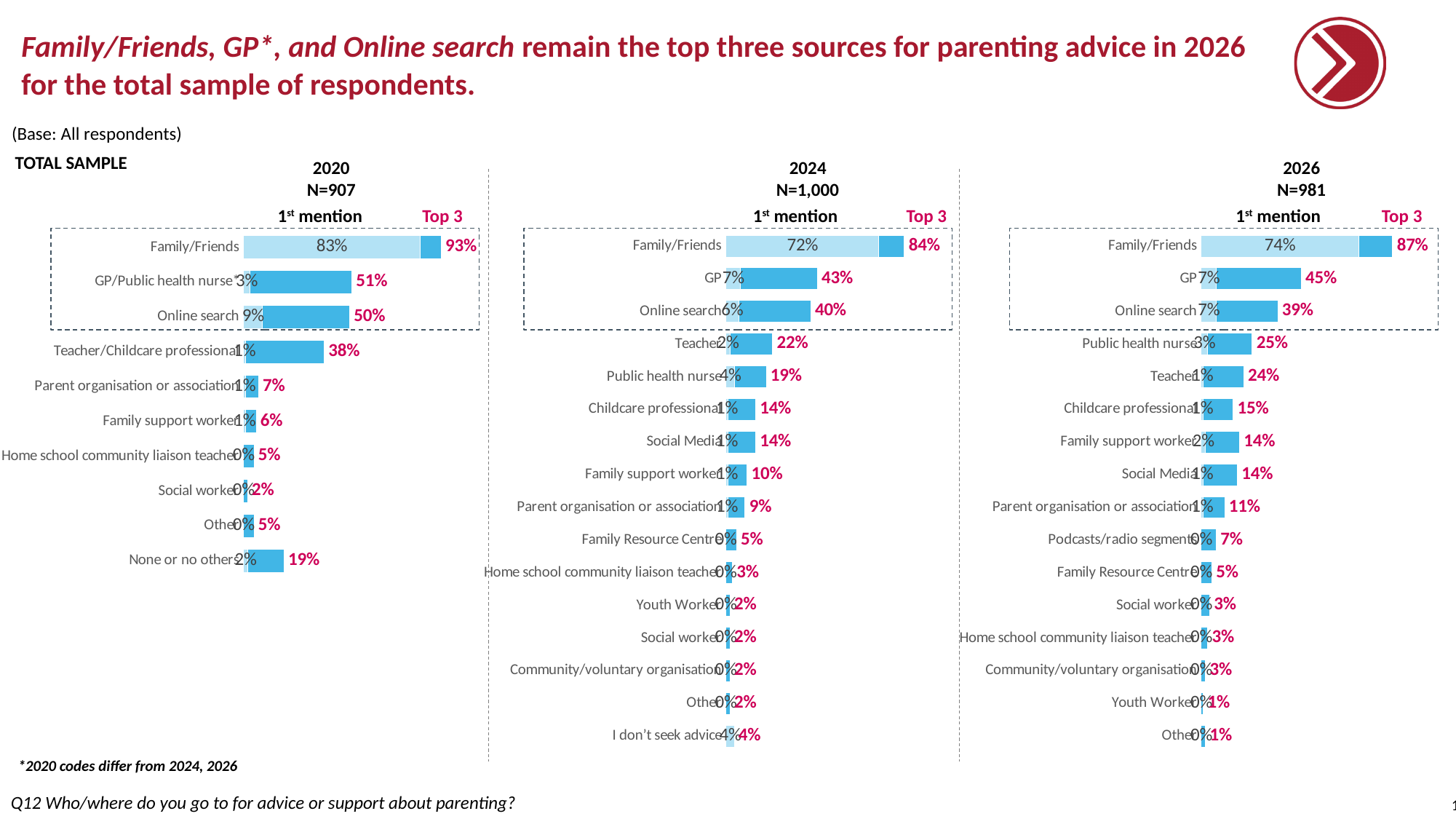
In the 2026 chart, what is the difference between the Top 3 values for GP and Online search? 6% In the 2026 chart, what is the Top 3 value for Public health nurse? 25% In the 2024 chart, which has the larger Top 3 value, Teacher or Public health nurse? Teacher What is the sample size (N) shown for the 2024 chart? N=1,000 In the 2020 chart, what is the 1st mention value for Family/Friends? 83% How many categories are shown in the 2024 chart? 16 In the 2020 chart, which category has the lowest Top 3 value? Social worker In the 2024 chart, which category has the highest Top 3 value? Family/Friends How many categories are shown in the 2020 chart? 10 In the 2024 chart, what is the Top 3 value for Online search? 40% In the 2026 chart, what is the Top 3 value for Family/Friends? 87% What type of chart is used for the 2026 data? Bar chart